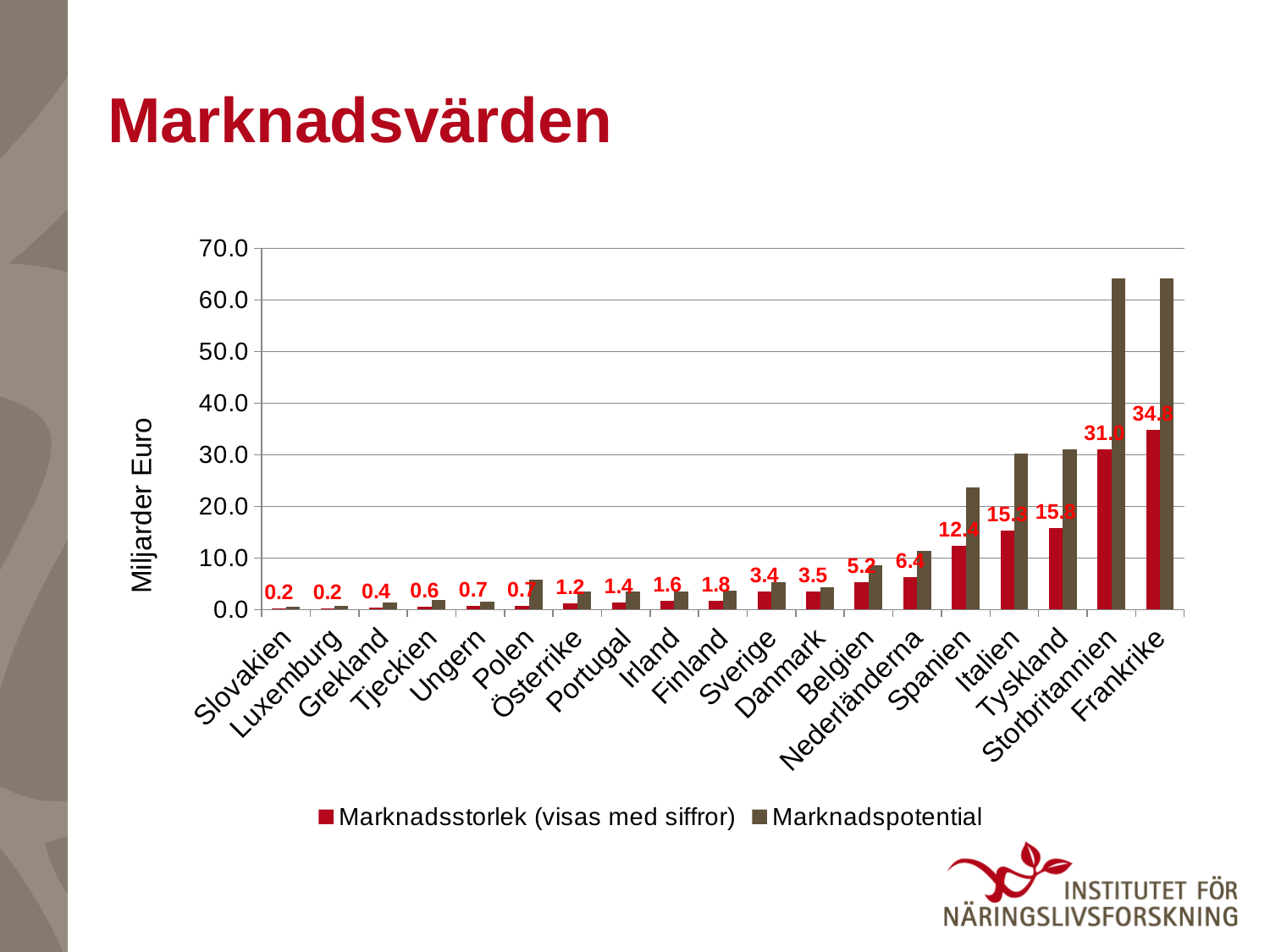
What is the Marknadsstorlek value for Sverige? 3.4 Is the Marknadspotential value for Spanien greater or less than 20.0? greater Which has the larger Marknadsstorlek value, Italien or Tyskland? Tyskland What is the Marknadsstorlek value for Spanien? 12.4 How many series does the legend list? 2 Is the Marknadspotential value for Frankrike greater or less than 60.0? greater Which country has the highest Marknadsstorlek value? Frankrike What kind of chart is shown on the slide? bar chart Do the Marknadsstorlek values rise or fall from left to right along the x axis? rise How many countries are shown on the x axis? 19 What is the Marknadsstorlek value for Frankrike? 34.8 What is the difference between the Marknadsstorlek values for Frankrike and Storbritannien? 3.8